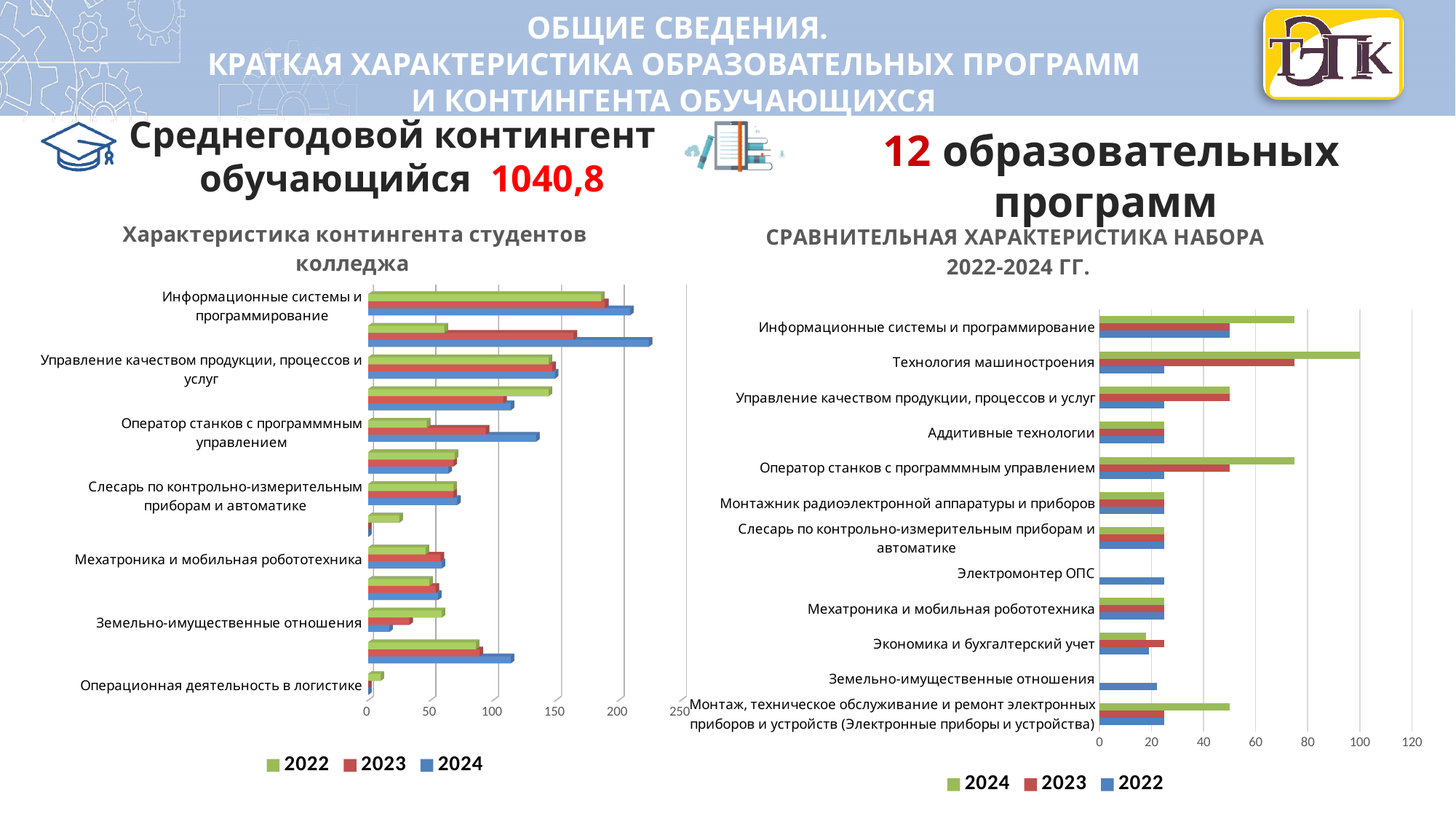
In the right chart 'СРАВНИТЕЛЬНАЯ ХАРАКТЕРИСТИКА НАБОРА 2022-2024 ГГ.', is the 2024 value for Информационные системы и программирование greater or less than 60? greater How many series does the legend of the right chart 'СРАВНИТЕЛЬНАЯ ХАРАКТЕРИСТИКА НАБОРА 2022-2024 ГГ.' list? 3 In the right chart 'СРАВНИТЕЛЬНАЯ ХАРАКТЕРИСТИКА НАБОРА 2022-2024 ГГ.', which is larger for Технология машиностроения: the 2023 value or the 2022 value? 2023 What kind of chart is the 'СРАВНИТЕЛЬНАЯ ХАРАКТЕРИСТИКА НАБОРА 2022-2024 ГГ.' chart on the right? Bar chart In the right chart 'СРАВНИТЕЛЬНАЯ ХАРАКТЕРИСТИКА НАБОРА 2022-2024 ГГ.', is the 2022 value for Электромонтер ОПС greater or less than 40? less In the left chart 'Характеристика контингента студентов колледжа', is the 2024 value for Информационные системы и программирование greater or less than 200? greater How many series does the legend of the left chart 'Характеристика контингента студентов колледжа' list? 3 In the right chart 'СРАВНИТЕЛЬНАЯ ХАРАКТЕРИСТИКА НАБОРА 2022-2024 ГГ.', which category has the highest 2024 value? Технология машиностроения How many categories are shown on the right chart 'СРАВНИТЕЛЬНАЯ ХАРАКТЕРИСТИКА НАБОРА 2022-2024 ГГ.'? 12 In the right chart 'СРАВНИТЕЛЬНАЯ ХАРАКТЕРИСТИКА НАБОРА 2022-2024 ГГ.', which series is the only one with a bar for Электромонтер ОПС? 2022 In the right chart 'СРАВНИТЕЛЬНАЯ ХАРАКТЕРИСТИКА НАБОРА 2022-2024 ГГ.', what is the 2024 value for Технология машиностроения? 100 What kind of chart is the left chart 'Характеристика контингента студентов колледжа'? Bar chart